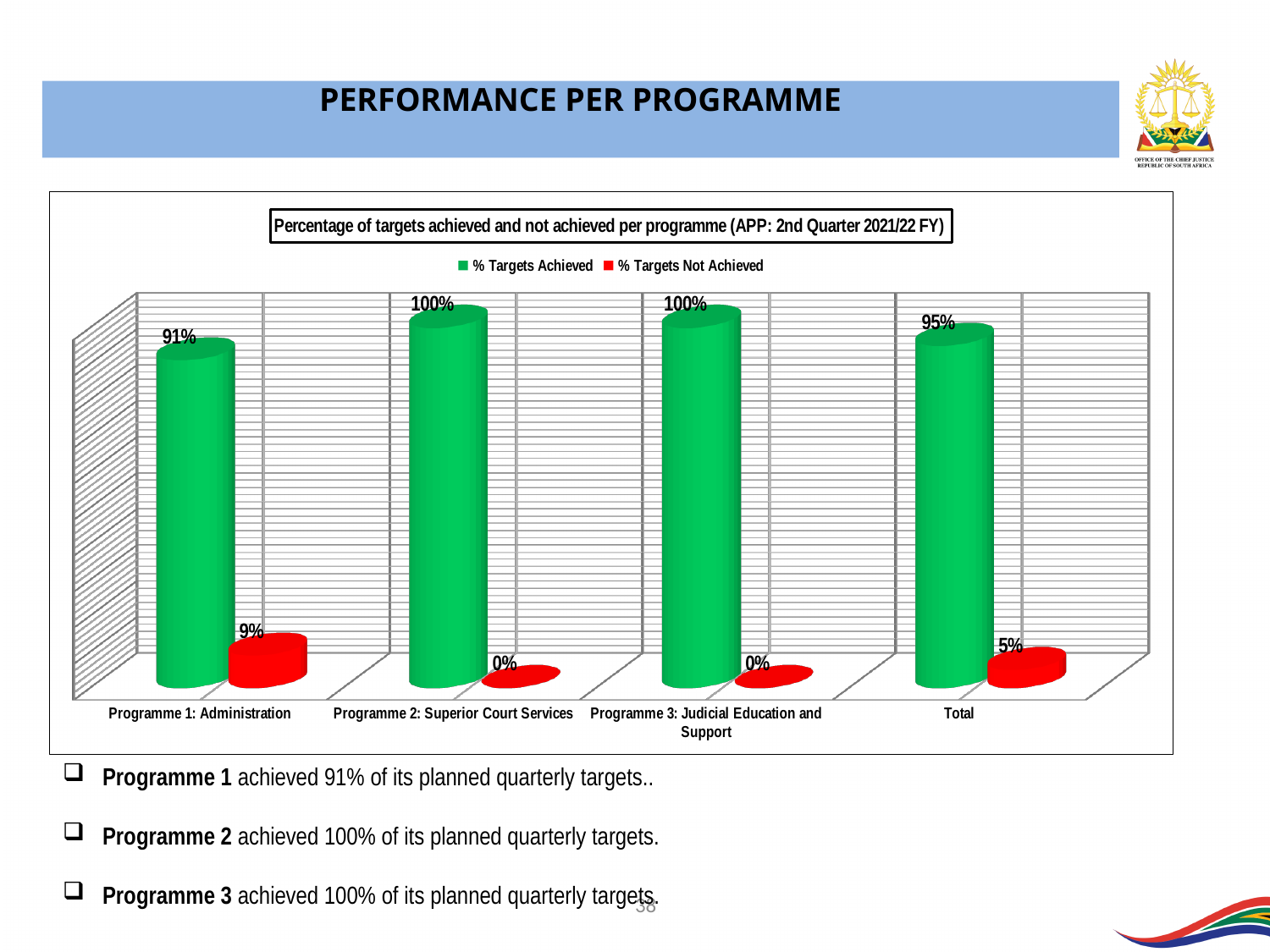
How many categories are shown on the x axis? 4 Which is larger, the % Targets Achieved value for Total or for Programme 1: Administration? Total What kind of chart is shown on the slide? Bar chart Which category has the highest % Targets Not Achieved value? Programme 1: Administration What is the % Targets Achieved value for Programme 1: Administration? 91% Which category has the lowest % Targets Achieved value? Programme 1: Administration What is the % Targets Achieved value for Programme 2: Superior Court Services? 100% Which colour represents the % Targets Not Achieved series? Red What is the % Targets Not Achieved value for Programme 3: Judicial Education and Support? 0% What is the difference between the % Targets Achieved values for Programme 2: Superior Court Services and Programme 1: Administration? 9% What is the % Targets Not Achieved value for Total? 5% How many series does the legend list? 2